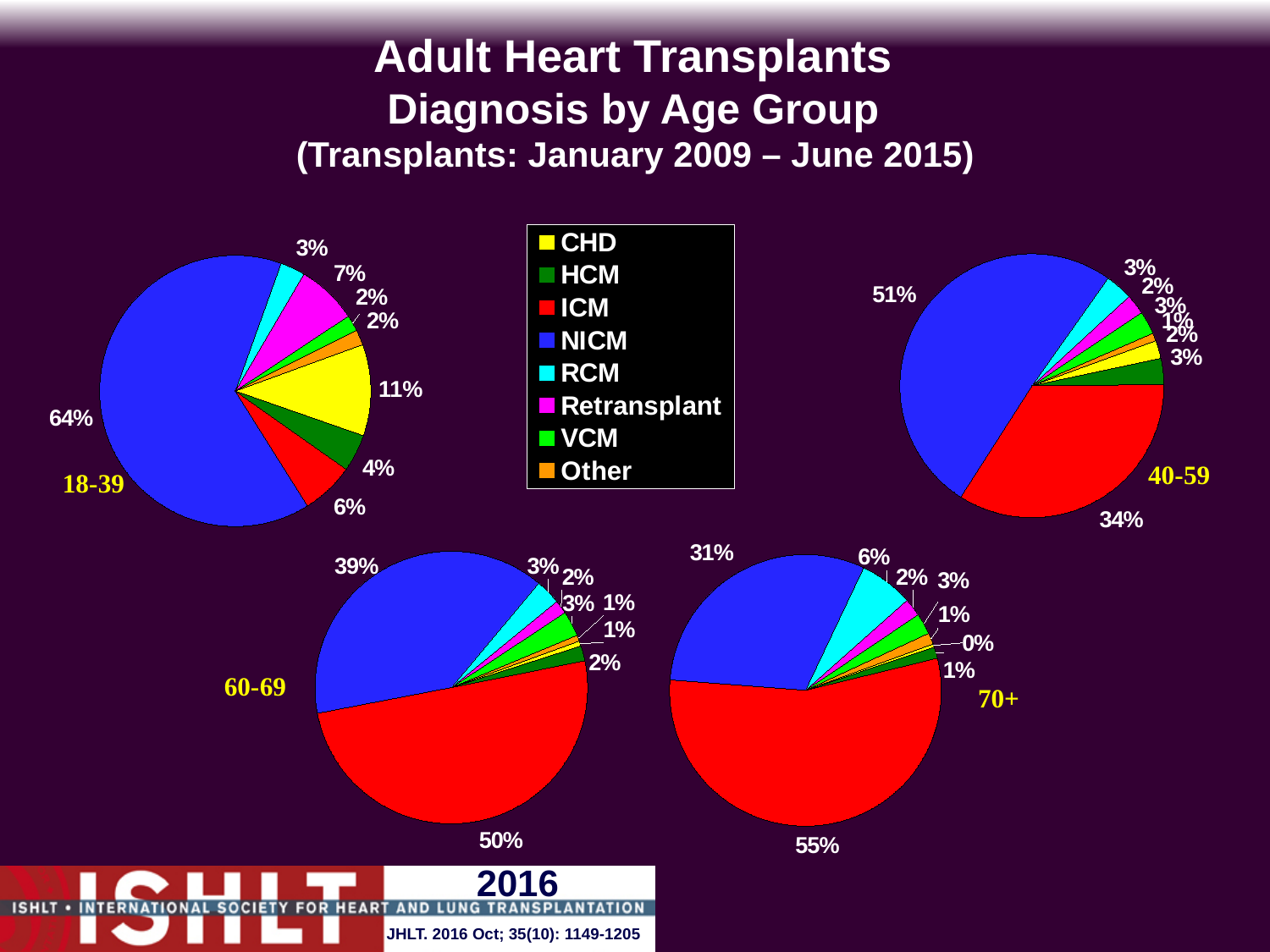
How many pie charts are shown on the slide? 4 In the 60-69 pie chart, what share is ICM? 50% In the 40-59 pie chart, which diagnosis has the largest share? NICM In the 18-39 pie chart, what share is CHD? 11% In the 40-59 pie chart, what share is ICM? 34% In the 18-39 pie chart, what is the difference between the NICM share and the ICM share? 58 percentage points In the 70+ pie chart, what share is NICM? 31% In the 18-39 pie chart, what share is NICM? 64% In the 70+ pie chart, which diagnosis has the largest share? ICM What kind of chart is used on this slide? Pie chart In the 60-69 pie chart, which is larger, the ICM share or the NICM share? ICM How many diagnosis categories does the legend list? 8